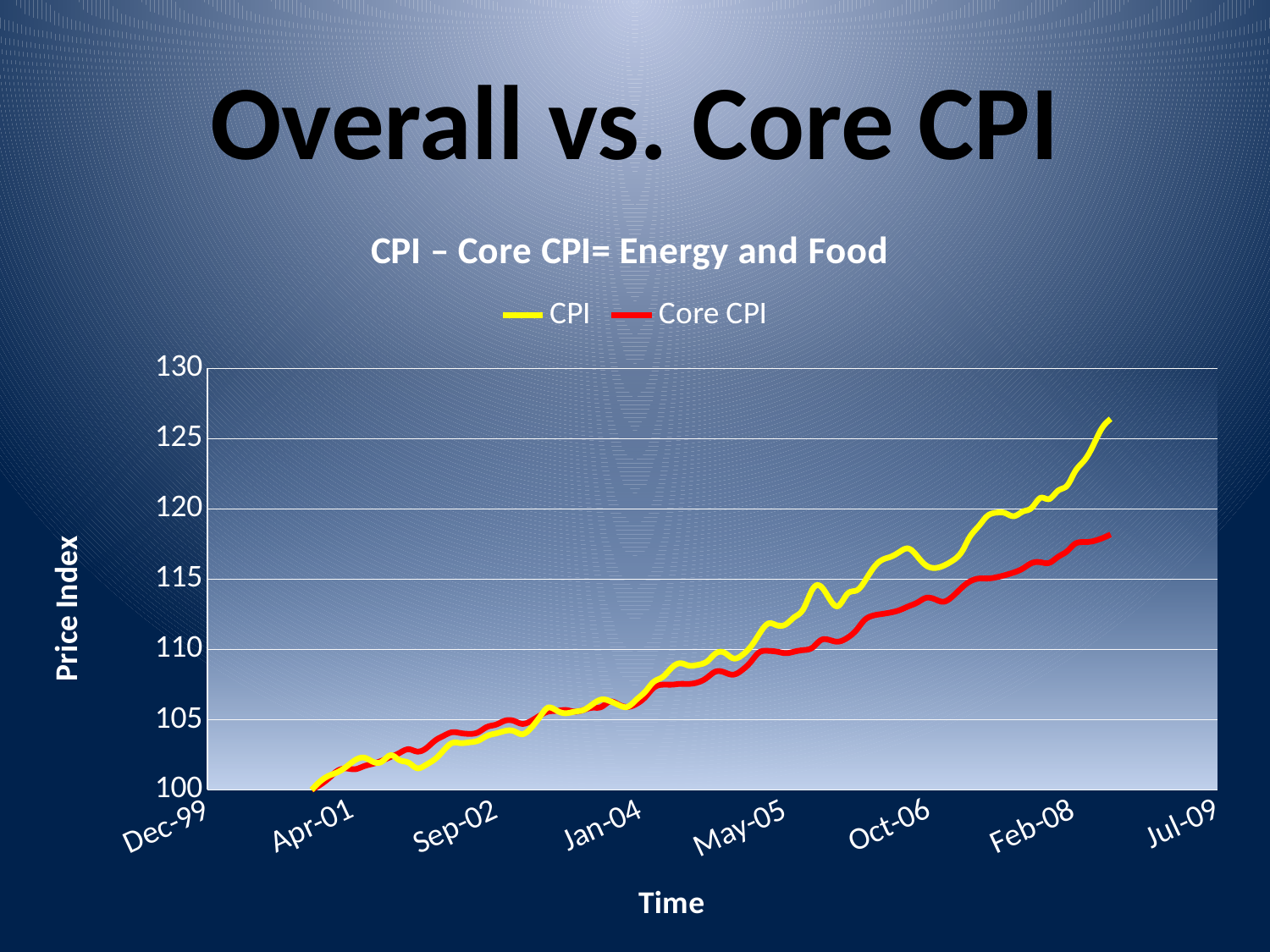
How many series does the legend list? 2 Is the final value of the Core CPI line greater or less than 120? less What are the two series named in the legend? CPI and Core CPI At the right end of the chart, which series is higher, CPI or Core CPI? CPI What kind of chart is shown on the slide? line chart Is the final value of the CPI line greater or less than 120? greater How many date labels are shown on the x axis? 8 Do the CPI values rise or fall over time along the x axis? rise Is the final value of the Core CPI line greater or less than 115? greater What is the title of the chart? CPI – Core CPI= Energy and Food Do the Core CPI values rise or fall over time along the x axis? rise